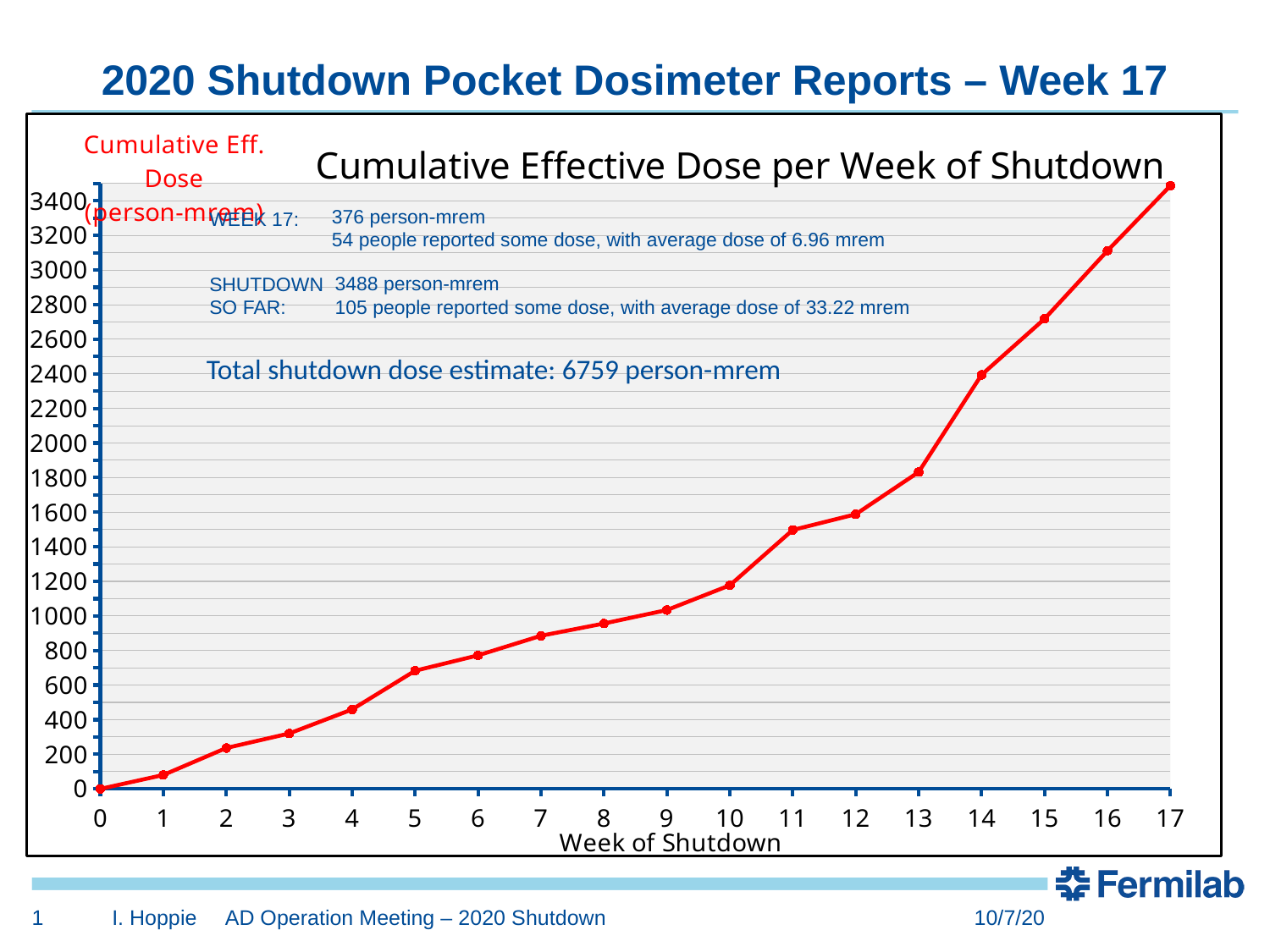
What is the title of the chart? Cumulative Effective Dose per Week of Shutdown At which week is the cumulative effective dose highest? 17 Is the value for week 5 greater or less than 800? less Which has the larger cumulative effective dose, week 9 or week 12? week 12 Is the value for week 14 greater or less than 2200? greater How many data points are plotted on the line? 18 What is the cumulative effective dose at week 0? 0 What kind of chart is shown on the slide? line chart Is the value for week 16 greater or less than 3000? greater What is the label of the x axis? Week of Shutdown At which week is the cumulative effective dose lowest? 0 Do the values rise or fall as the week of shutdown increases? rise